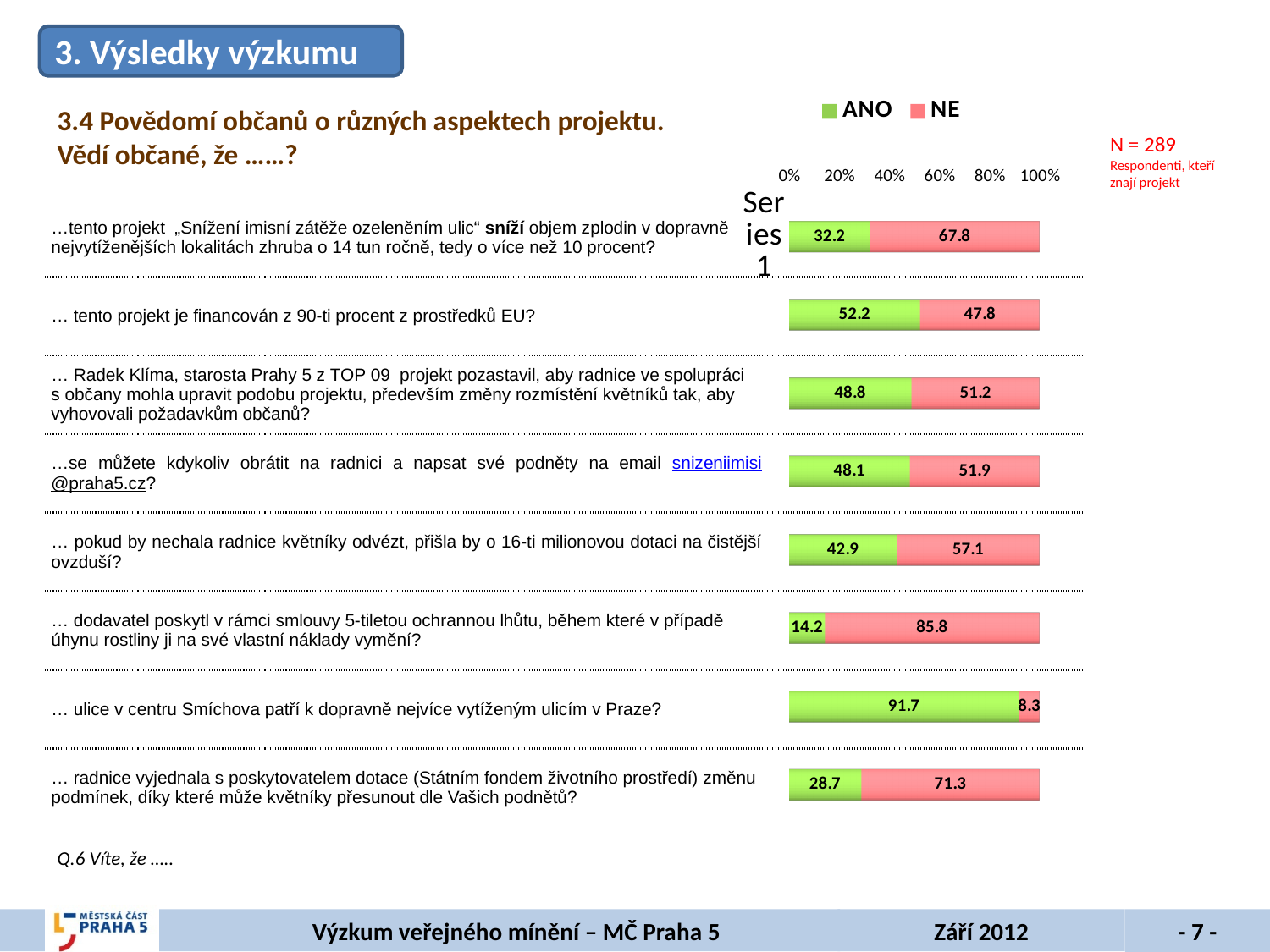
Which is larger for the statement about Radek Klíma pausing the project: the ANO value or the NE value? NE What is the difference between the NE and ANO values for the statement about the project reducing emissions by about 14 tons per year (first bar)? 35.6 Which statement has the lowest ANO value? … dodavatel poskytl v rámci smlouvy 5-tiletou ochrannou lhůtu, během které v případě úhynu rostliny ji na své vlastní náklady vymění? What are the two series named in the chart legend? ANO and NE Which statement has the highest ANO value? … ulice v centru Smíchova patří k dopravně nejvíce vytíženým ulicím v Praze? How many statements (bars) are plotted in the chart? 8 Is the ANO value for the statement about the town hall negotiating a change of conditions with the grant provider (last bar) greater or less than 40%? less What is the ANO value for the statement that the project is financed 90% from EU funds ("tento projekt je financován z 90-ti procent z prostředků EU")? 52.2 What is the total of the ANO and NE values for the statement about losing a 16 million subsidy if the planters were removed? 100 How many series does the chart legend list? 2 What type of chart is shown on the slide? bar chart What is the NE value for the statement that the supplier provided a 5-year protection period ("dodavatel poskytl v rámci smlouvy 5-tiletou ochrannou lhůtu")? 85.8